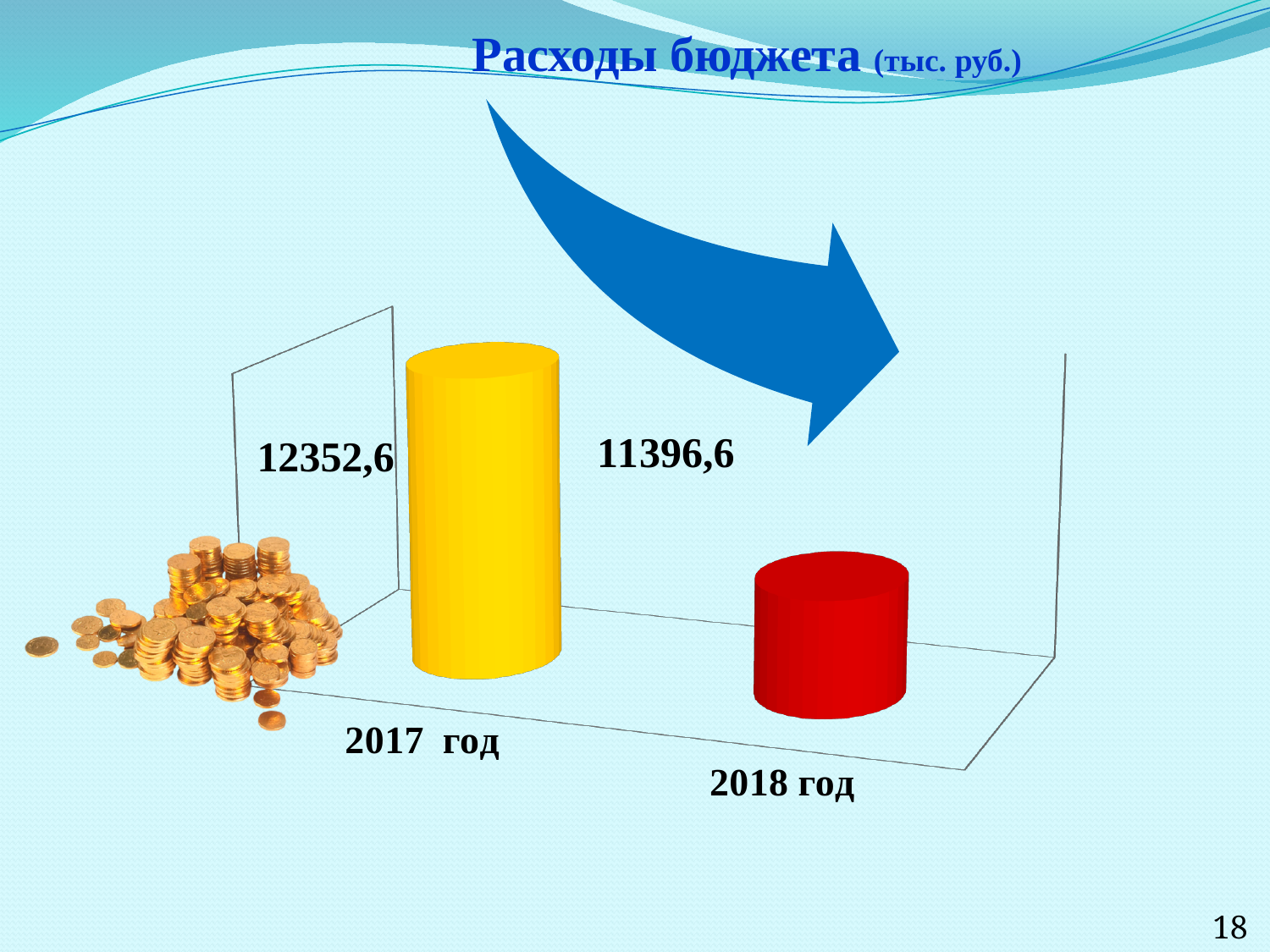
Which year has the higher budget expenditure? 2017 год How many years (categories) are shown in the chart? 2 What is the title of the chart? Расходы бюджета (тыс. руб.) What is the budget expenditure value shown for 2018 год? 11396,6 Do the values rise or fall from 2017 to 2018? fall By how much did budget expenditure decrease from 2017 to 2018 (in тыс. руб.)? 956,0 Which year has the lower budget expenditure? 2018 год Is the value for 2017 год larger or smaller than the value for 2018 год? larger What type of chart is used on the slide? bar chart What colour is the bar for 2018 год? red What is the budget expenditure value shown for 2017 год? 12352,6